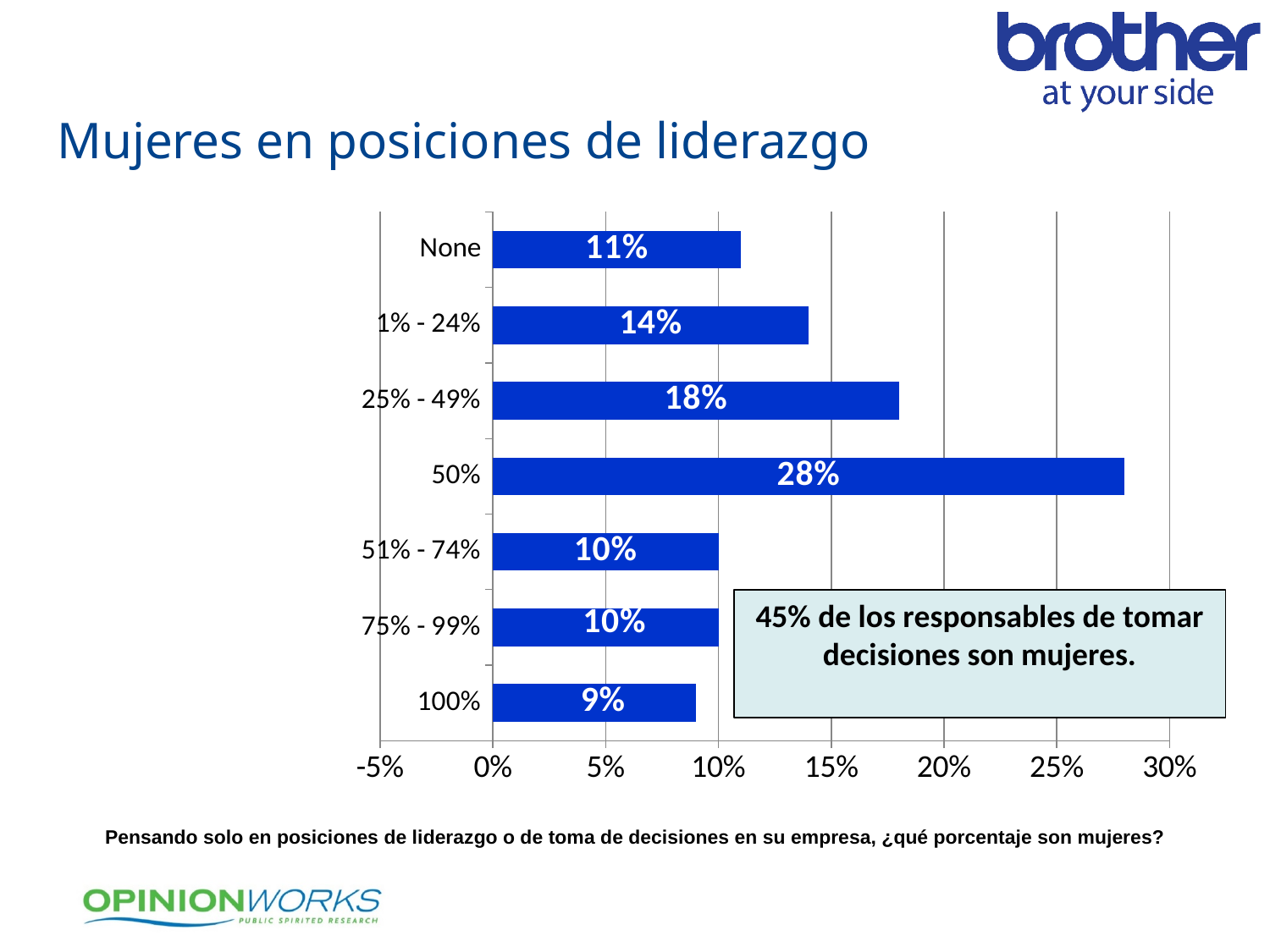
What is the value for the "100%" category? 9% What is the value for the "50%" category? 28% Which category has the lowest value? 100% Which is larger, the value for "1% - 24%" or the value for "None"? 1% - 24% What is the difference between the values for "50%" and "25% - 49%"? 10% What is the title of the slide? Mujeres en posiciones de liderazgo What kind of chart is shown on the slide? Bar chart What does the text box on the chart say? 45% de los responsables de tomar decisiones son mujeres. What is the value for the "25% - 49%" category? 18% What is the value for the "None" category? 11% Which category has the highest value? 50% How many categories are shown in the chart? 7